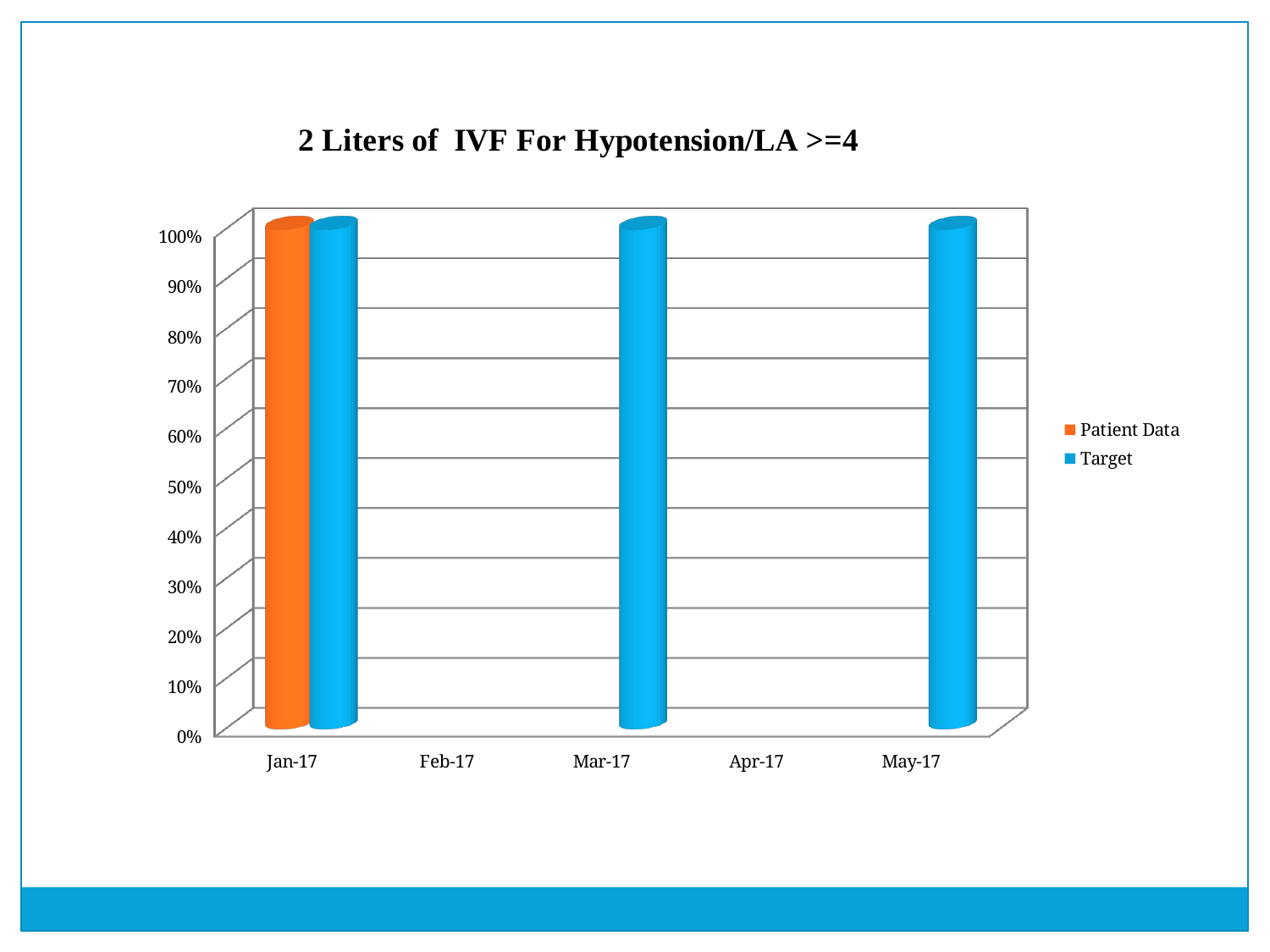
What is the title of the chart? 2 Liters of IVF For Hypotension/LA >=4 What is the Patient Data value for Jan-17? 100% Is the Target value for May-17 greater or less than 80%? greater What is the Target value for Jan-17? 100% How many months have a Target bar plotted? 3 How many months have a Patient Data bar plotted? 1 How many month categories are shown on the x axis? 5 Is the Target value for Mar-17 greater or less than 90%? greater How many series does the legend list? 2 Is the Patient Data value for Jan-17 greater or less than 50%? greater What kind of chart is shown on the slide? bar chart Which colour represents the Target series? blue